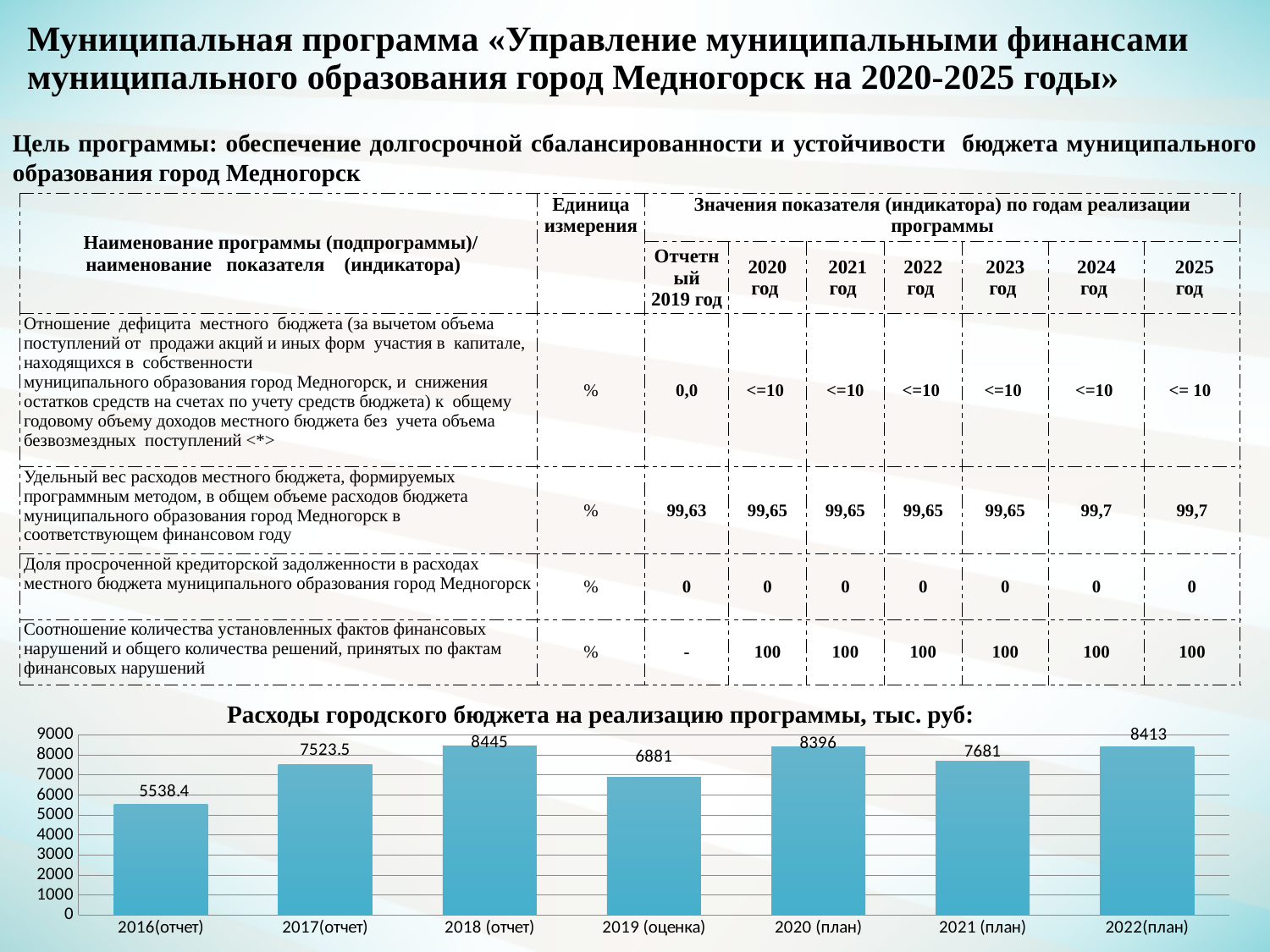
How many categories are shown on the x axis of the bar chart? 7 Which is larger, the value for 2020 (план) or the value for 2021 (план)? 2020 (план) Is the value for 2019 (оценка) greater or less than 7000? less What is the title of the bar chart? Расходы городского бюджета на реализацию программы, тыс. руб: What is the difference between the values for 2020 (план) and 2019 (оценка)? 1515 Which category has the highest value in the bar chart? 2018 (отчет) What is the value for 2021 (план) in the bar chart? 7681 What type of chart is shown at the bottom of the slide? bar chart Which category has the lowest value in the bar chart? 2016(отчет) What is the difference between the values for 2018 (отчет) and 2016(отчет)? 2906.6 What is the value for 2016(отчет) in the bar chart? 5538.4 What is the value for 2019 (оценка) in the bar chart? 6881